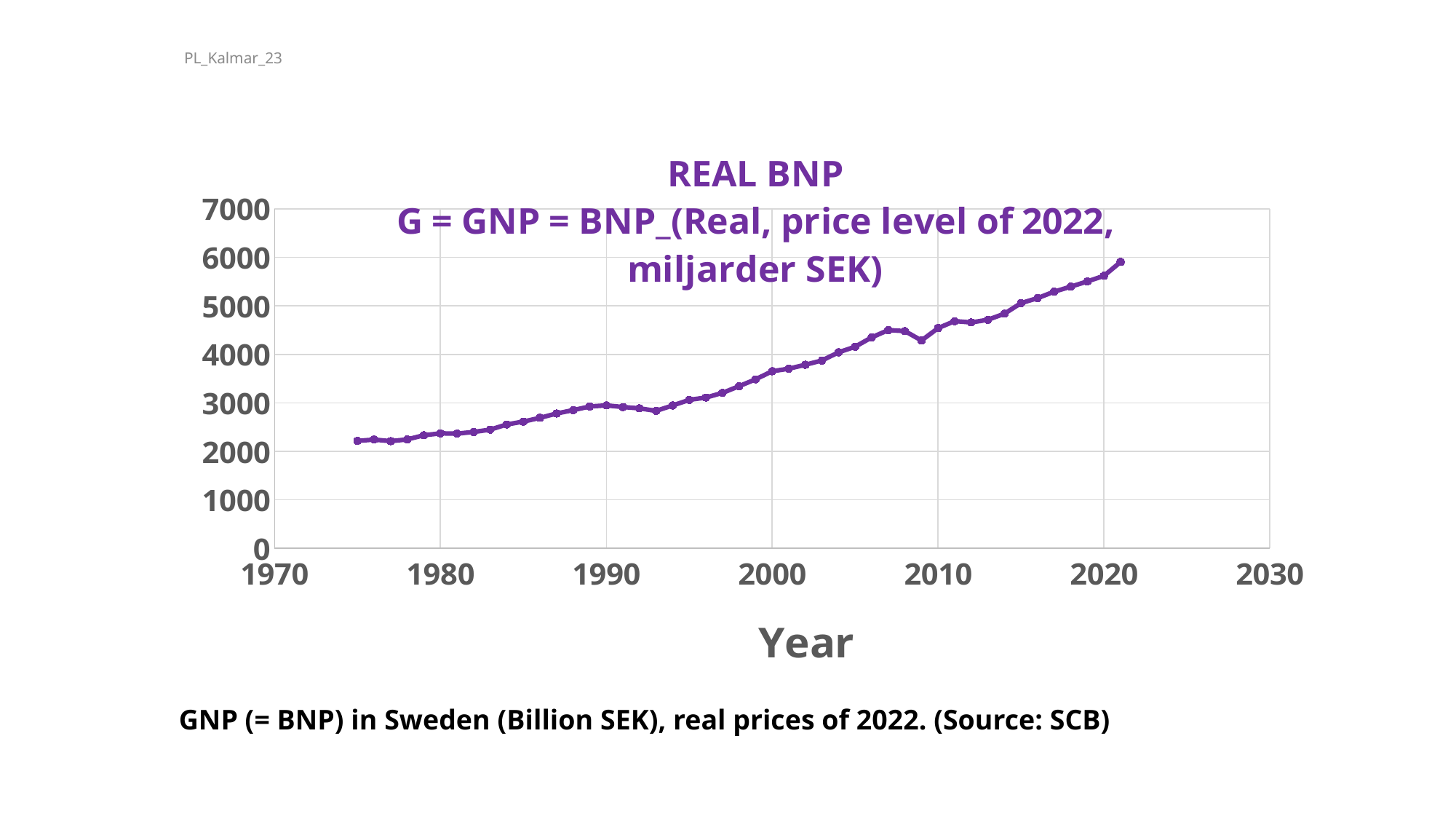
What is the label of the x axis? Year What kind of chart is shown on the slide? line chart Is the value for 2010 greater or less than 4000? greater Is the value for 2000 greater or less than 3000? greater In which year is the plotted value highest? 2021 Do the values generally rise or fall from 1975 to 2021? rise Is the value for 2021 greater or less than 5000? greater What is the title of the chart? REAL BNP G = GNP = BNP_(Real, price level of 2022, miljarder SEK) Which year has the larger value, 1990 or 2020? 2020